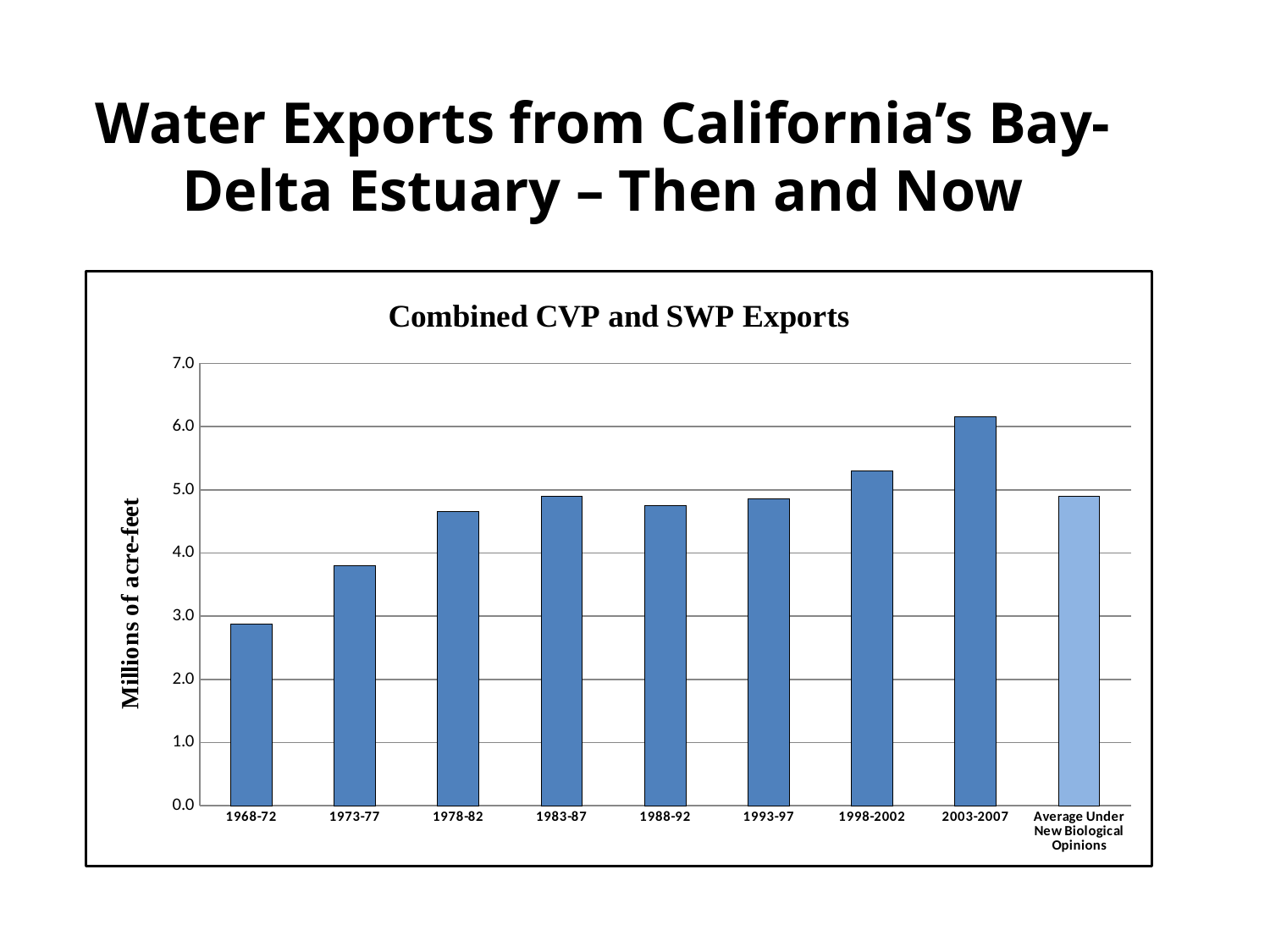
How many bars are plotted in the chart? 9 Do the combined exports generally rise or fall from 1968-72 through 2003-2007? Rise What is the label on the vertical axis of the chart? Millions of acre-feet Is the value for 2003-2007 greater or less than 6.0? greater Which period has the lowest combined exports? 1968-72 Which period has the highest combined exports? 2003-2007 Is the value for 1998-2002 greater or less than 5.0? greater Is the value for 1973-77 greater or less than 4.0? less Which is larger, the value for 1998-2002 or the value for 1988-92? 1998-2002 What is the title of the chart? Combined CVP and SWP Exports What type of chart is shown on the slide? Bar chart